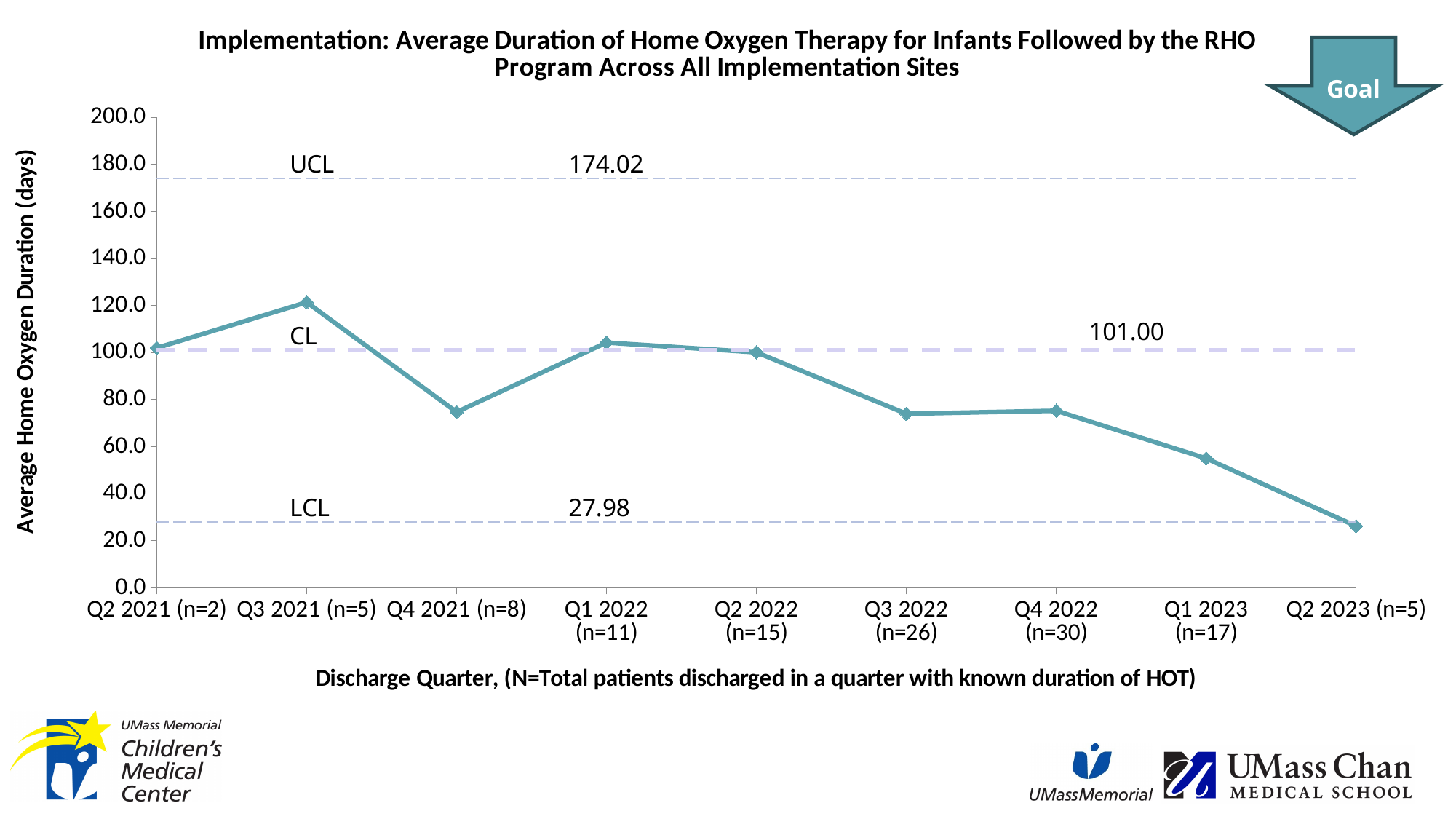
What kind of chart is shown on the slide? line chart Which discharge quarter has the lowest average home oxygen duration? Q2 2023 (n=5) What is the label of the y axis? Average Home Oxygen Duration (days) What is the value of the center line (CL) shown on the chart? 101.00 Which has a higher average home oxygen duration, Q1 2022 (n=11) or Q3 2022 (n=26)? Q1 2022 (n=11) Is the average home oxygen duration for Q1 2023 (n=17) greater or less than 60.0 days? less Which discharge quarter has the highest average home oxygen duration? Q3 2021 (n=5) From Q2 2022 to Q2 2023, does the average home oxygen duration rise or fall? fall Is the average home oxygen duration for Q3 2021 (n=5) greater or less than 100.0 days? greater How many discharge quarters are plotted on the x axis? 9 What is the value of the upper control limit (UCL) shown on the chart? 174.02 What is the value of the lower control limit (LCL) shown on the chart? 27.98